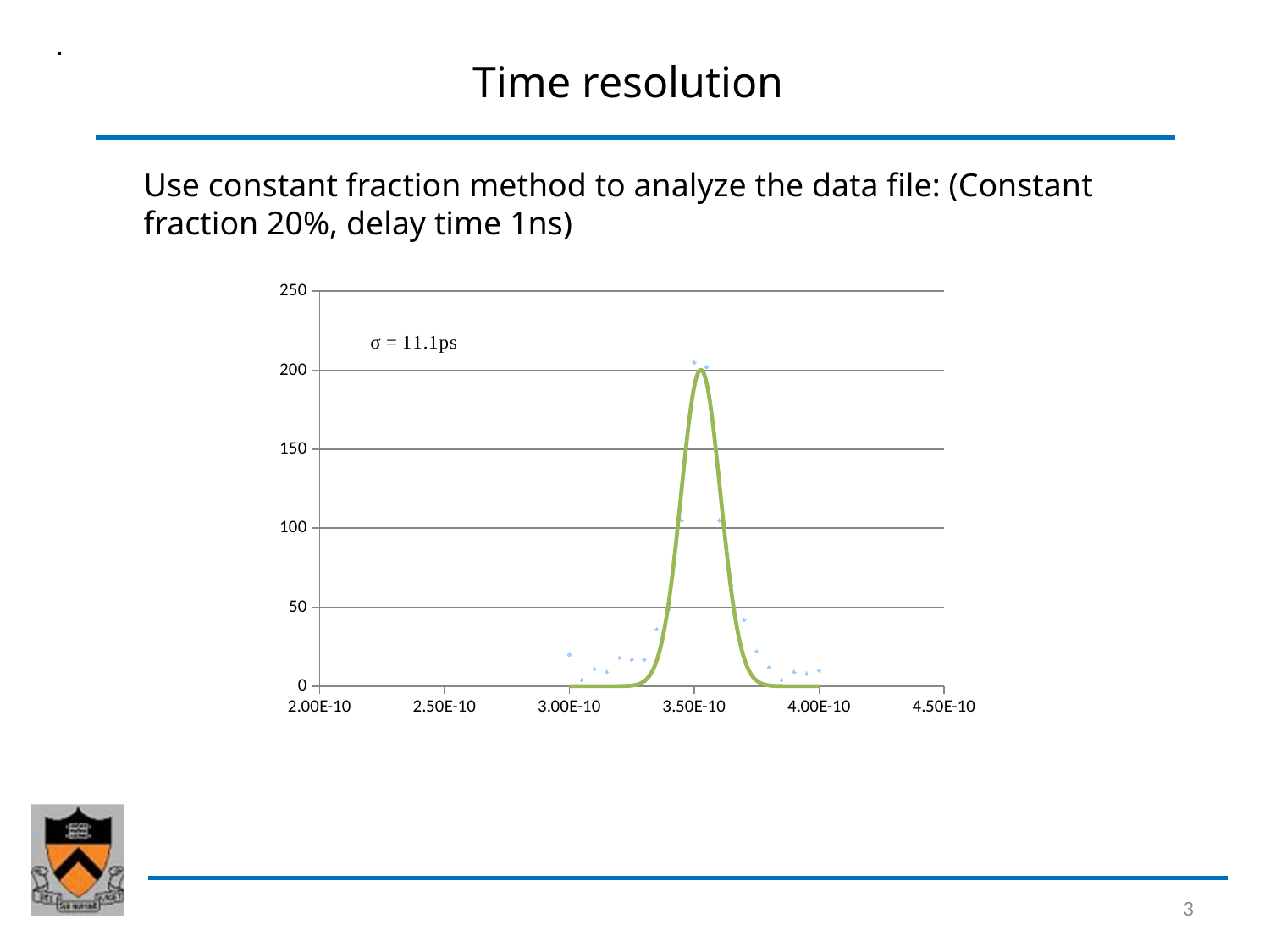
Do the plotted values rise or fall as x goes from 3.00E-10 to 3.50E-10? rise What kind of chart is shown on the slide? scatter chart Is the highest plotted value on the chart greater or less than 150? greater What is the highest tick value shown on the y axis of the chart? 250 Is the highest plotted value on the chart greater or less than 250? less Are the plotted values near 4.00E-10 on the x axis greater or less than 50? less Which x position has the larger plotted value, around 3.00E-10 or around 3.50E-10? around 3.50E-10 What value of σ is annotated on the chart? σ = 11.1ps Do the plotted values rise or fall as x goes from 3.50E-10 to 4.00E-10? fall